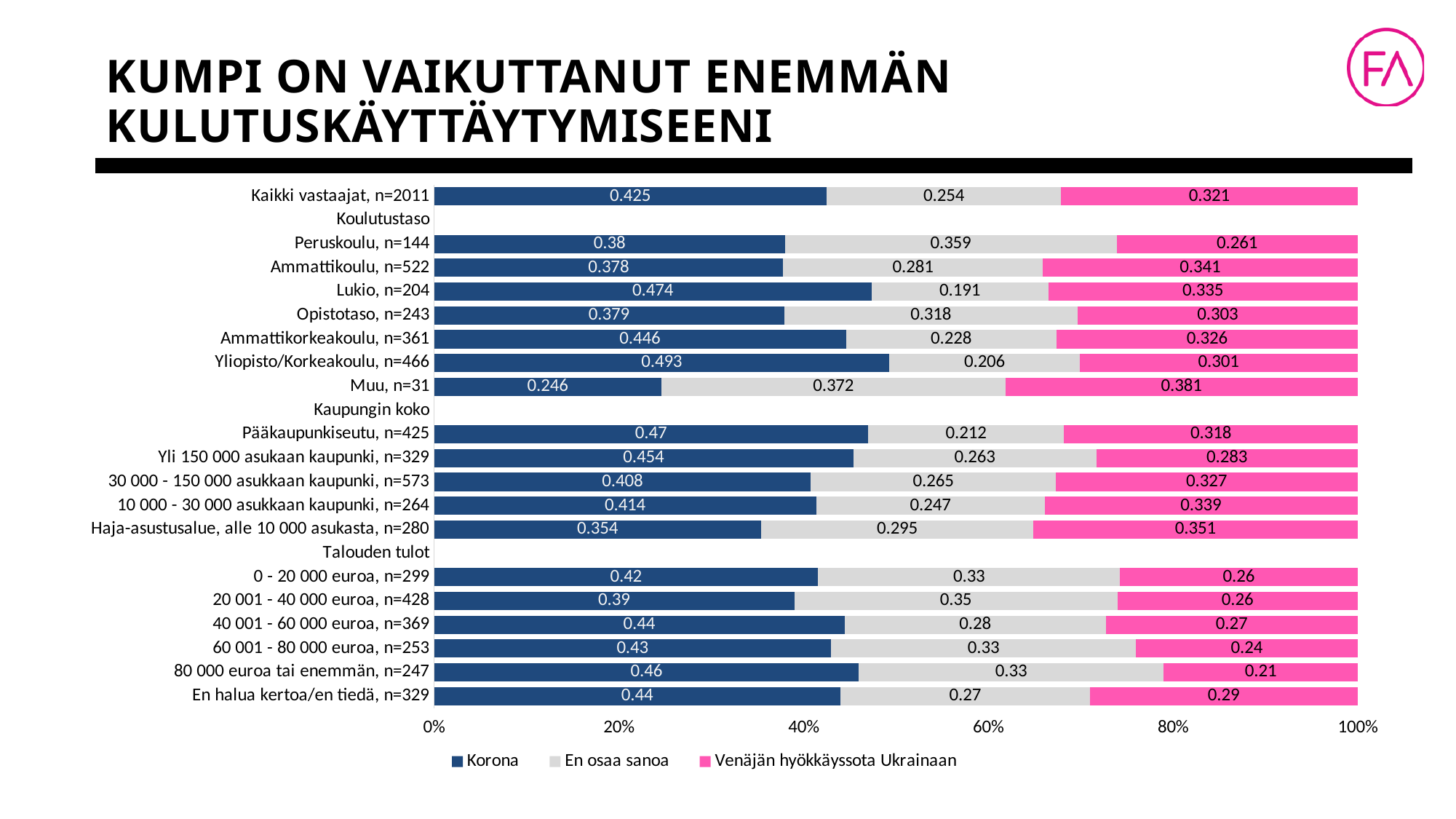
What colour represents Venäjän hyökkäyssota Ukrainaan in the chart? Pink Which category has the lowest Korona value? Muu, n=31 What is the Venäjän hyökkäyssota Ukrainaan value for Muu, n=31? 0.381 How many categories are plotted under the Talouden tulot group? 6 Which has the larger Korona value: Pääkaupunkiseutu, n=425 or Haja-asustusalue, alle 10 000 asukasta, n=280? Pääkaupunkiseutu, n=425 Which category has the lowest Venäjän hyökkäyssota Ukrainaan value? 80 000 euroa tai enemmän, n=247 What is the difference between the Korona values for Lukio, n=204 and Peruskoulu, n=144? 0.094 How many series does the legend list? 3 Which category has the highest Korona value? Yliopisto/Korkeakoulu, n=466 What kind of chart is shown on the slide? Stacked bar chart What is the En osaa sanoa value for Lukio, n=204? 0.191 What is the Korona value for Kaikki vastaajat, n=2011? 0.425